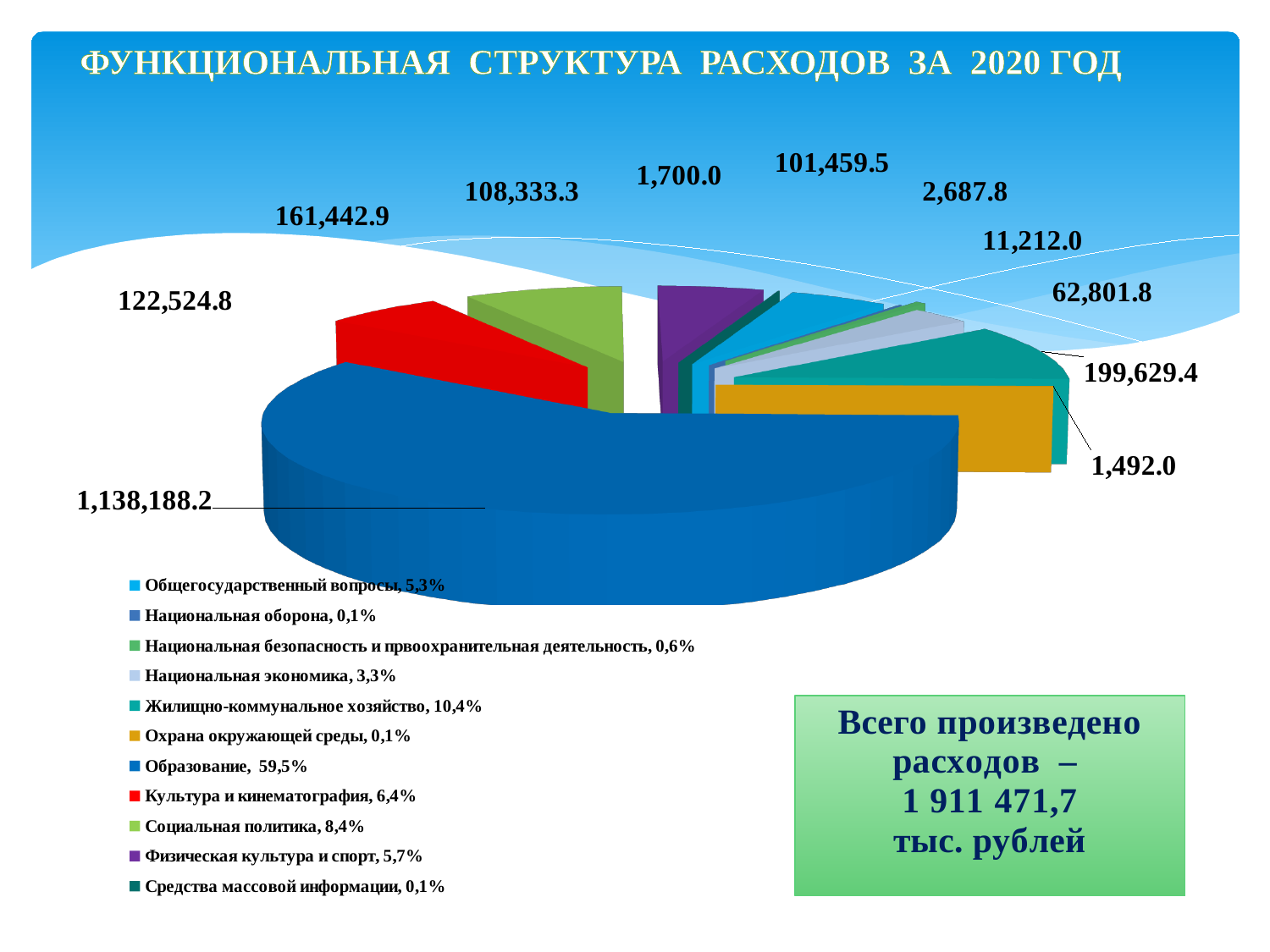
What value is labelled for the Охрана окружающей среды slice? 1,492.0 What kind of chart is shown on the slide? Pie chart What share of the pie does Культура и кинематография account for, according to the legend? 6,4% Which is larger: the value for Образование or the value for Жилищно-коммунальное хозяйство? Образование What value is labelled for the Образование slice? 1,138,188.2 Which category has the largest slice of the pie chart? Образование How many categories does the legend of the pie chart list? 11 What share of the pie does Социальная политика account for, according to the legend? 8,4% What value is labelled for the Жилищно-коммунальное хозяйство slice? 199,629.4 What is the title of the chart on the slide? ФУНКЦИОНАЛЬНАЯ СТРУКТУРА РАСХОДОВ ЗА 2020 ГОД What share of the pie does Образование account for, according to the legend? 59,5% What is the difference between the Образование value (1,138,188.2) and the Жилищно-коммунальное хозяйство value (199,629.4)? 938,558.8